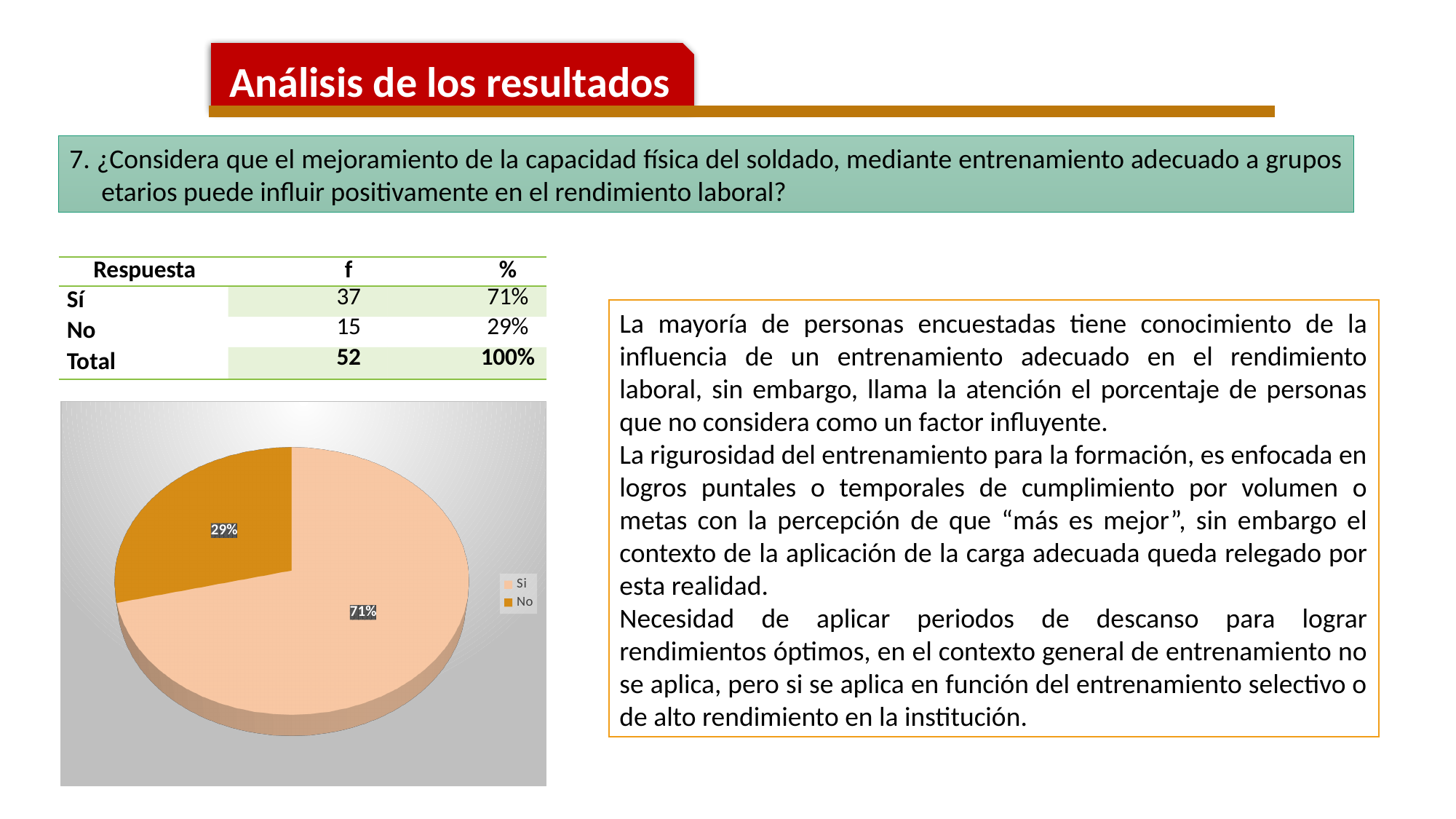
What percentage does the 'No' slice of the pie chart show? 29% What is the difference in percentage points between the 'Si' and 'No' slices? 42 How many entries does the pie chart legend list? 2 Which slice of the pie chart is the smallest? No Which slice of the pie chart is the largest? Si What kind of chart is shown on the slide? pie chart What percentage does the 'Si' slice of the pie chart show? 71% What colour is the 'Si' slice in the pie chart? light peach Which is larger in the pie chart, 'Si' or 'No'? Si How many slices does the pie chart have? 2 What colour is the 'No' slice in the pie chart? orange